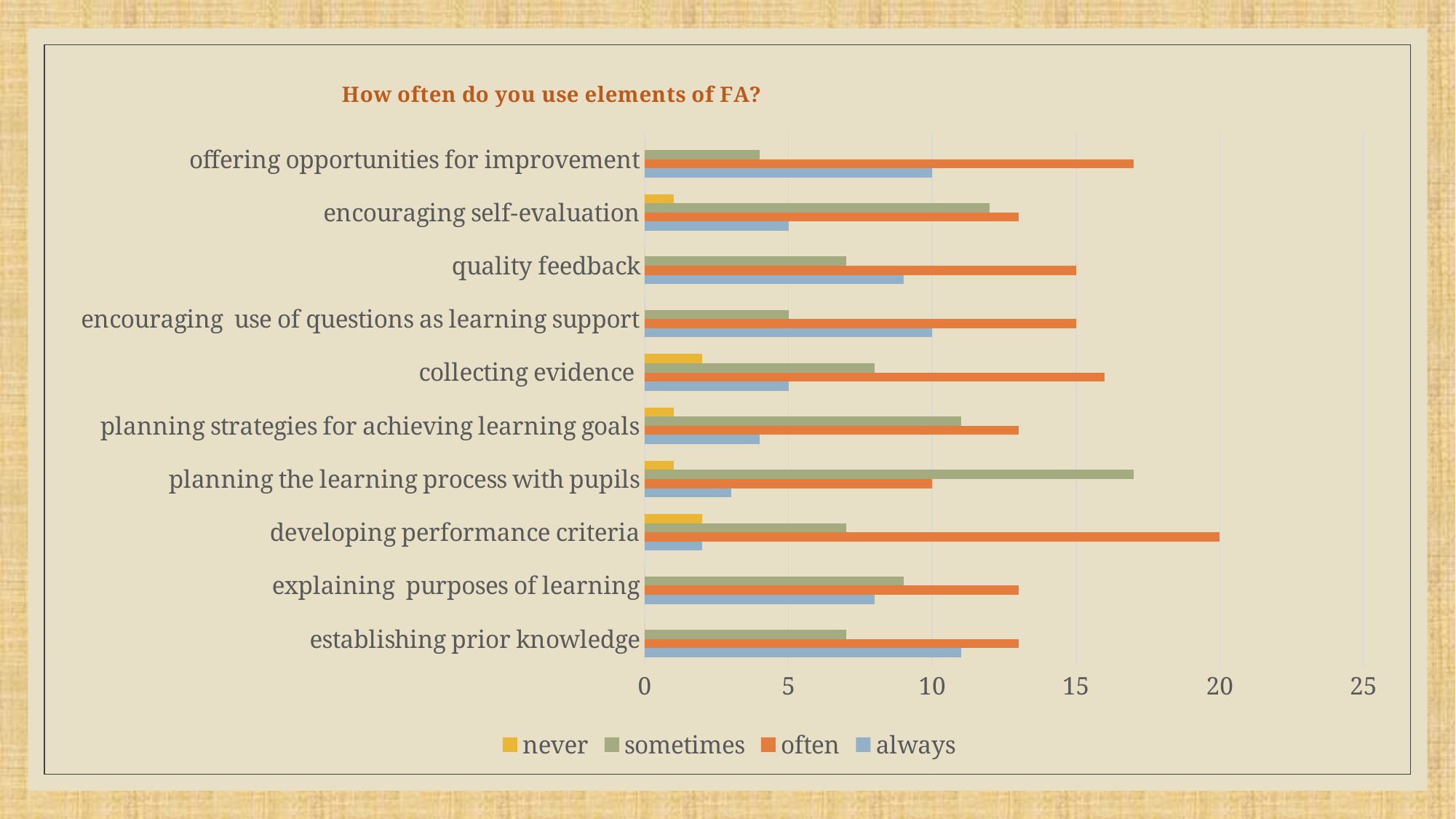
What is the 'often' value for 'developing performance criteria'? 20 Is the 'often' value for 'collecting evidence' greater or less than 15? greater What is the title of the chart? How often do you use elements of FA? What type of chart is shown on the slide? bar chart How many series does the legend list? 4 How many categories are shown on the chart? 10 What is the 'often' value for 'quality feedback'? 15 For 'encouraging self-evaluation', which is larger: the 'sometimes' value or the 'always' value? sometimes Is the 'always' value for 'planning the learning process with pupils' greater or less than 5? less What is the 'always' value for 'offering opportunities for improvement'? 10 Which category has the highest 'often' value? developing performance criteria Which category has the highest 'sometimes' value? planning the learning process with pupils